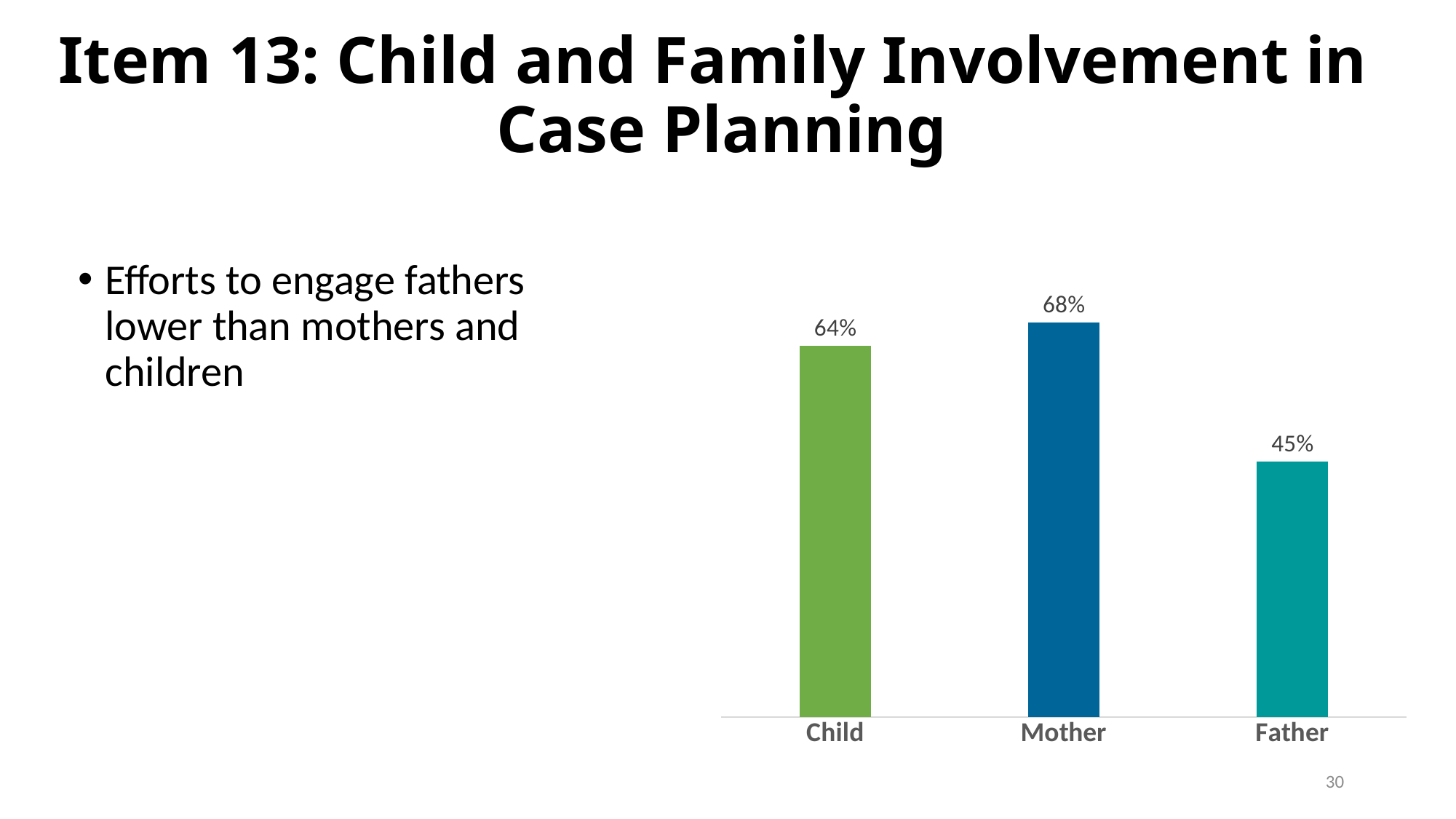
What is the value for Father? 45% What is the value for Mother? 68% Which category has the lowest value? Father What is the value for Child? 64% What colour is the bar for Father? Teal Which category has the highest value? Mother Which is larger, the value for Child or the value for Father? Child What is the difference between the values for Mother and Father? 23% What kind of chart is shown on the slide? Bar chart What is the difference between the values for Mother and Child? 4% How many categories are shown in the chart? 3 What colour is the bar for Mother? Dark blue